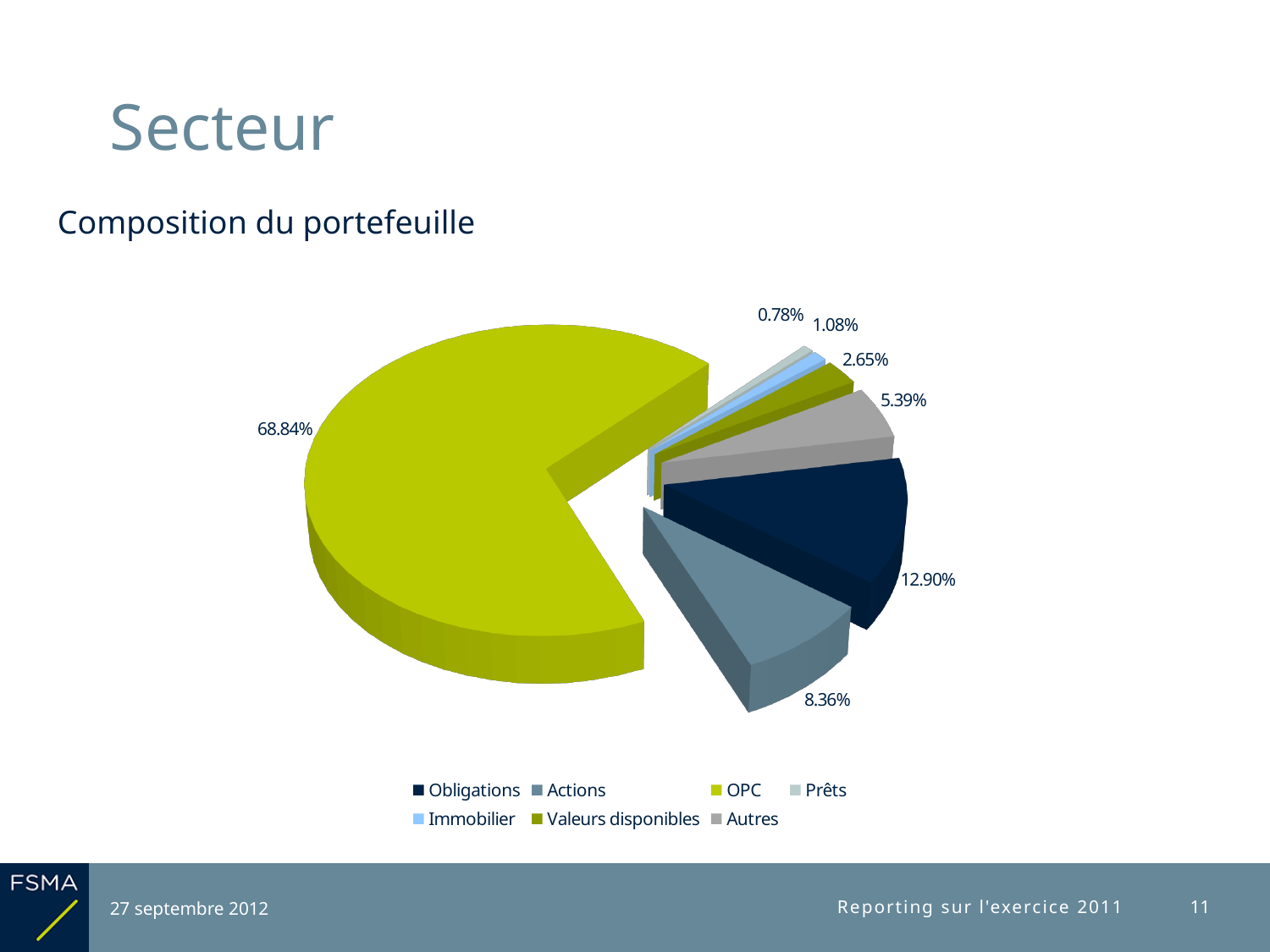
What is the subtitle above the chart? Composition du portefeuille What share of the portfolio is Obligations? 12.90% Which has a larger share, Autres or Valeurs disponibles? Autres What share of the portfolio is Valeurs disponibles? 2.65% What share of the portfolio is Actions? 8.36% What kind of chart is shown on the slide? pie chart Which category has the largest share of the portfolio? OPC Which category has the smallest share of the portfolio? Prêts What share of the portfolio is Autres? 5.39% How many categories does the legend list? 7 What is the difference between the shares of Obligations and Actions? 4.54% What share of the portfolio is OPC? 68.84%